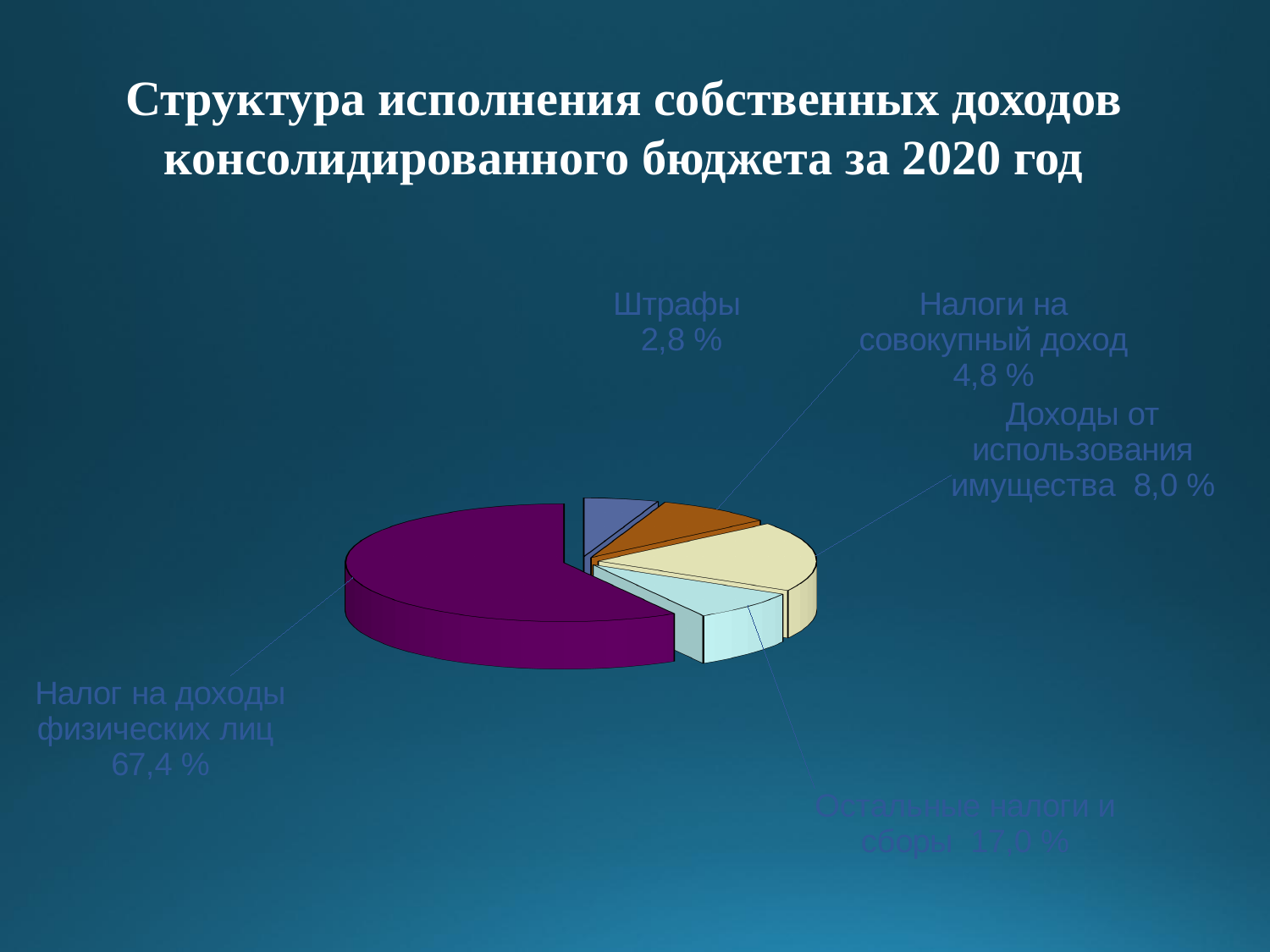
What is the value shown for "Доходы от использования имущества"? 8,0 % What is the value shown for "Остальные налоги и сборы"? 17,0 % Which category has the smallest slice of the pie? Штрафы What share of the pie does "Налог на доходы физических лиц" have? 67,4 % What is the difference between the shares of "Доходы от использования имущества" and "Штрафы"? 5,2 % Which is larger: "Доходы от использования имущества" or "Налоги на совокупный доход"? Доходы от использования имущества How many slices does the pie chart have? 5 What is the value shown for "Штрафы"? 2,8 % What is the title of the slide containing the chart? Структура исполнения собственных доходов консолидированного бюджета за 2020 год What kind of chart is shown on the slide? Pie chart What is the value shown for "Налоги на совокупный доход"? 4,8 % Which category has the largest slice of the pie? Налог на доходы физических лиц